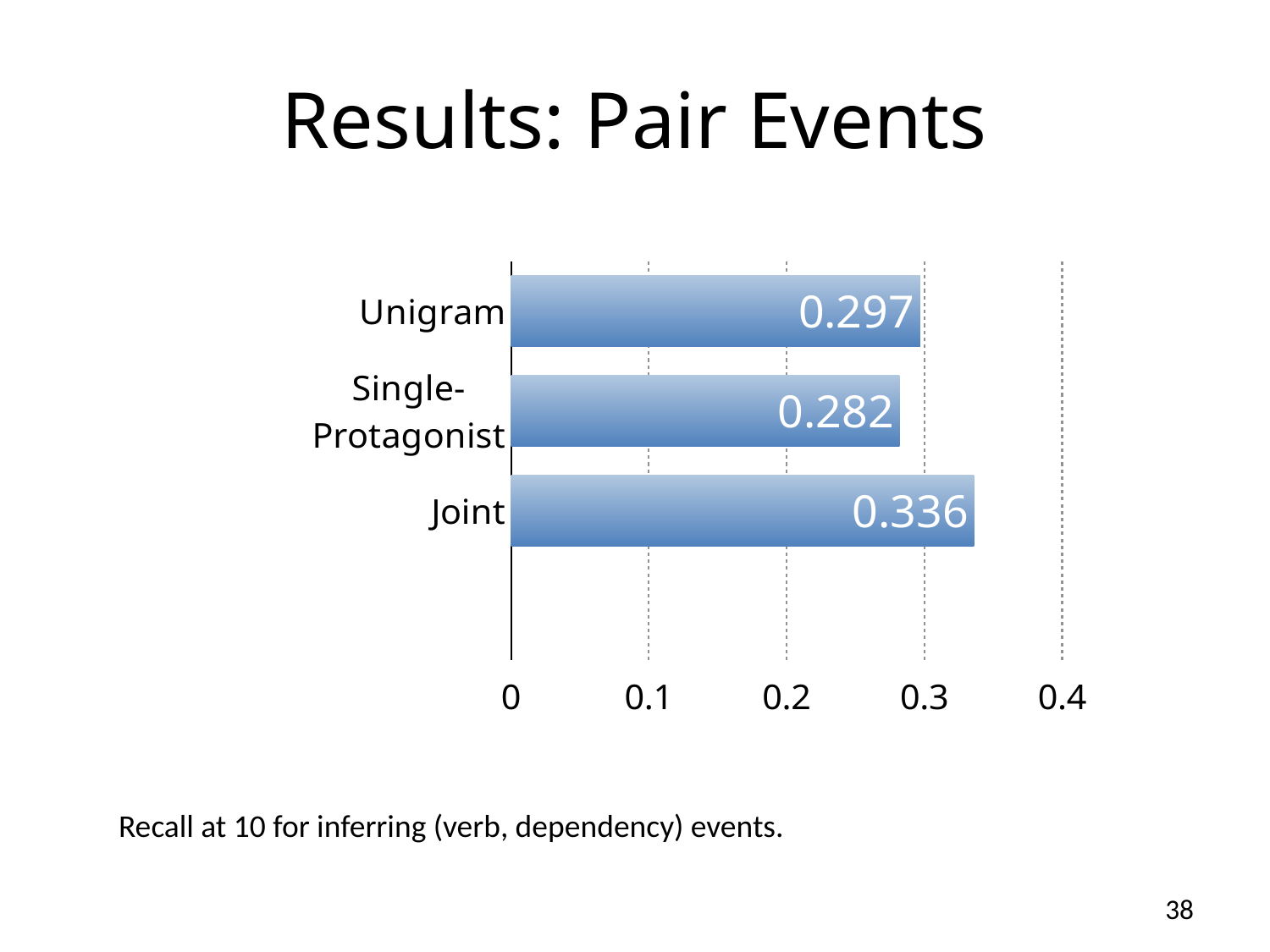
What kind of chart is shown on the slide? bar chart What is the value for Joint? 0.336 Is the value for Joint greater or less than 0.3? greater Which category has the highest value? Joint What is the value for Unigram? 0.297 What is the title of the slide containing the chart? Results: Pair Events What is the value for Single-Protagonist? 0.282 Which category has the lowest value? Single-Protagonist What is the difference between the values for Joint and Unigram? 0.039 What is the difference between the values for Unigram and Single-Protagonist? 0.015 Which is larger, the value for Joint or the value for Single-Protagonist? Joint How many categories are shown in the chart? 3